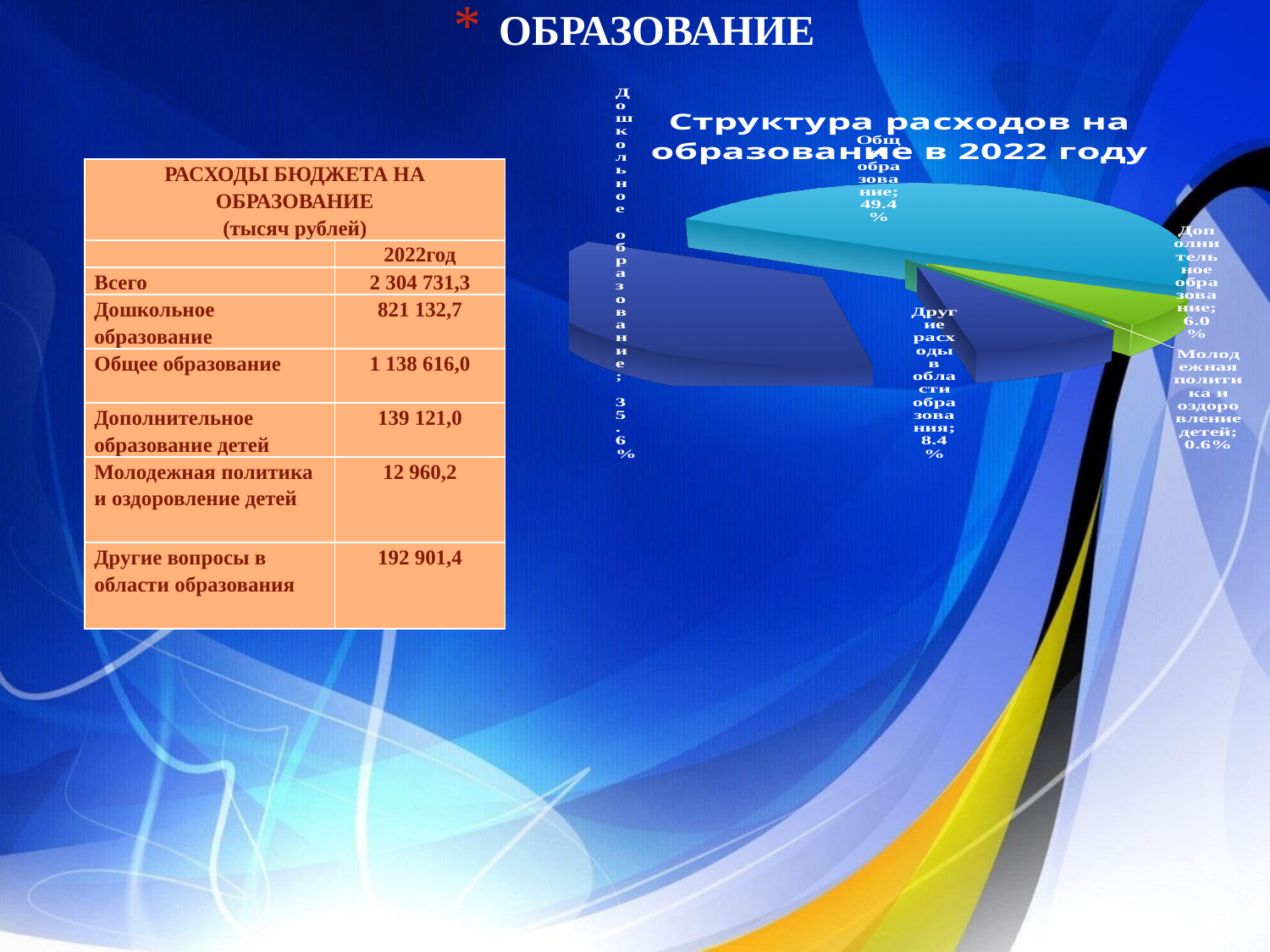
What share of the pie does Дополнительное образование have? 6.0% Which slice of the pie is the largest? Общее образование What is the difference in percentage points between Общее образование and Дошкольное образование? 13.8 What share of the pie does Дошкольное образование have? 35.6% What share of the pie does Другие расходы в области образования have? 8.4% What is the title of the chart? Структура расходов на образование в 2022 году What kind of chart is shown on the slide? pie chart How many slices does the pie chart have? 5 What share of the pie does Молодежная политика и оздоровление детей have? 0.6% Which is larger: the share for Другие расходы в области образования or the share for Дополнительное образование? Другие расходы в области образования Which slice of the pie is the smallest? Молодежная политика и оздоровление детей What share of the pie does Общее образование have? 49.4%